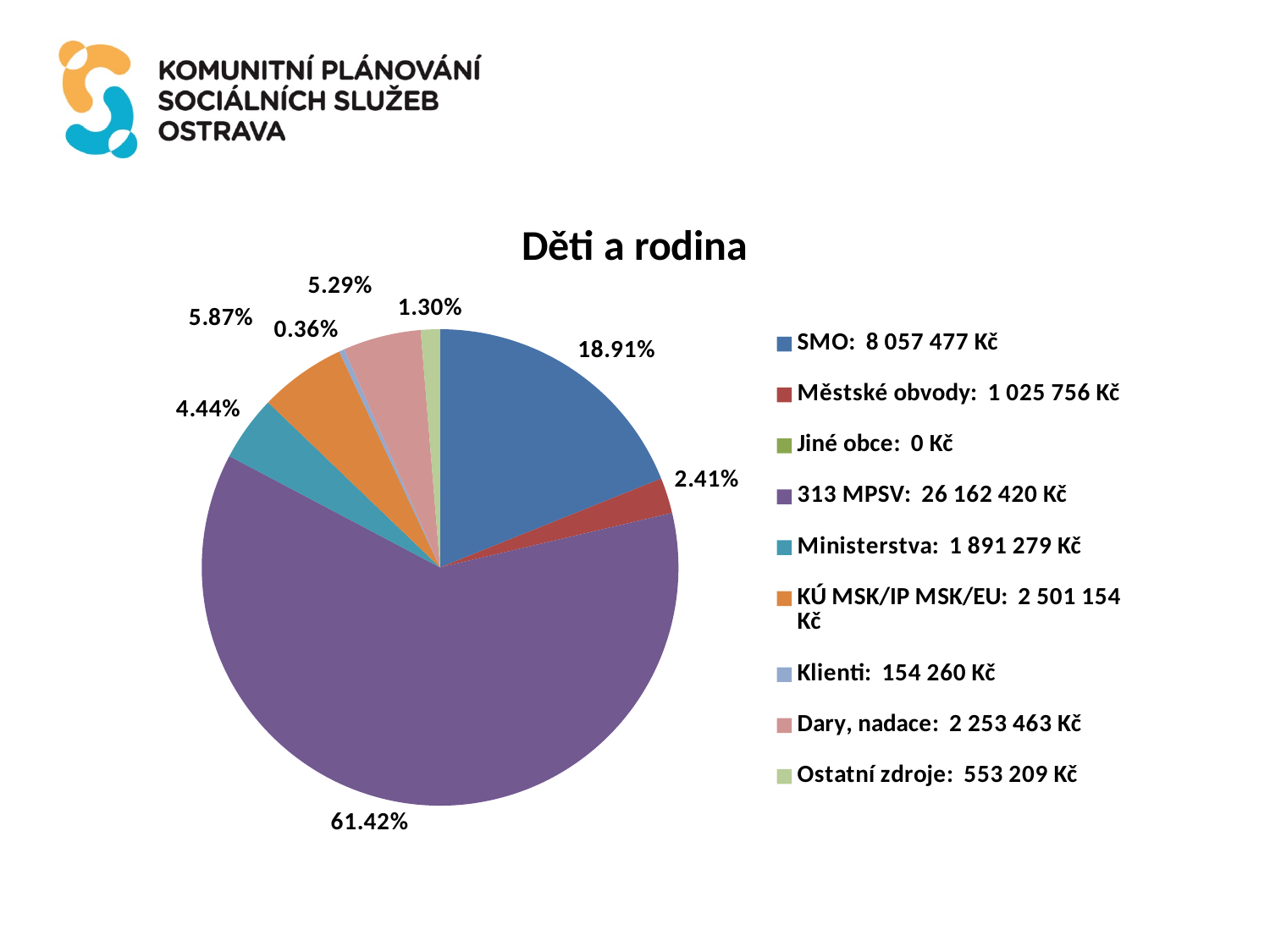
Which source has the largest share of the pie? 313 MPSV What amount does the legend give for Dary, nadace? 2 253 463 Kč What amount does the legend give for SMO? 8 057 477 Kč What is the difference between the amounts for Městské obvody and Ostatní zdroje? 472 547 Kč What percentage share of the pie does the SMO slice have? 18.91% What is the title of the chart? Děti a rodina How many entries does the chart legend list? 9 What amount does the legend give for 313 MPSV? 26 162 420 Kč Which source has the smallest non-zero share of the pie? Klienti What type of chart is shown on the slide? pie chart What percentage share of the pie does the 313 MPSV slice have? 61.42% Which is larger, the amount for Ministerstva or the amount for KÚ MSK/IP MSK/EU? KÚ MSK/IP MSK/EU